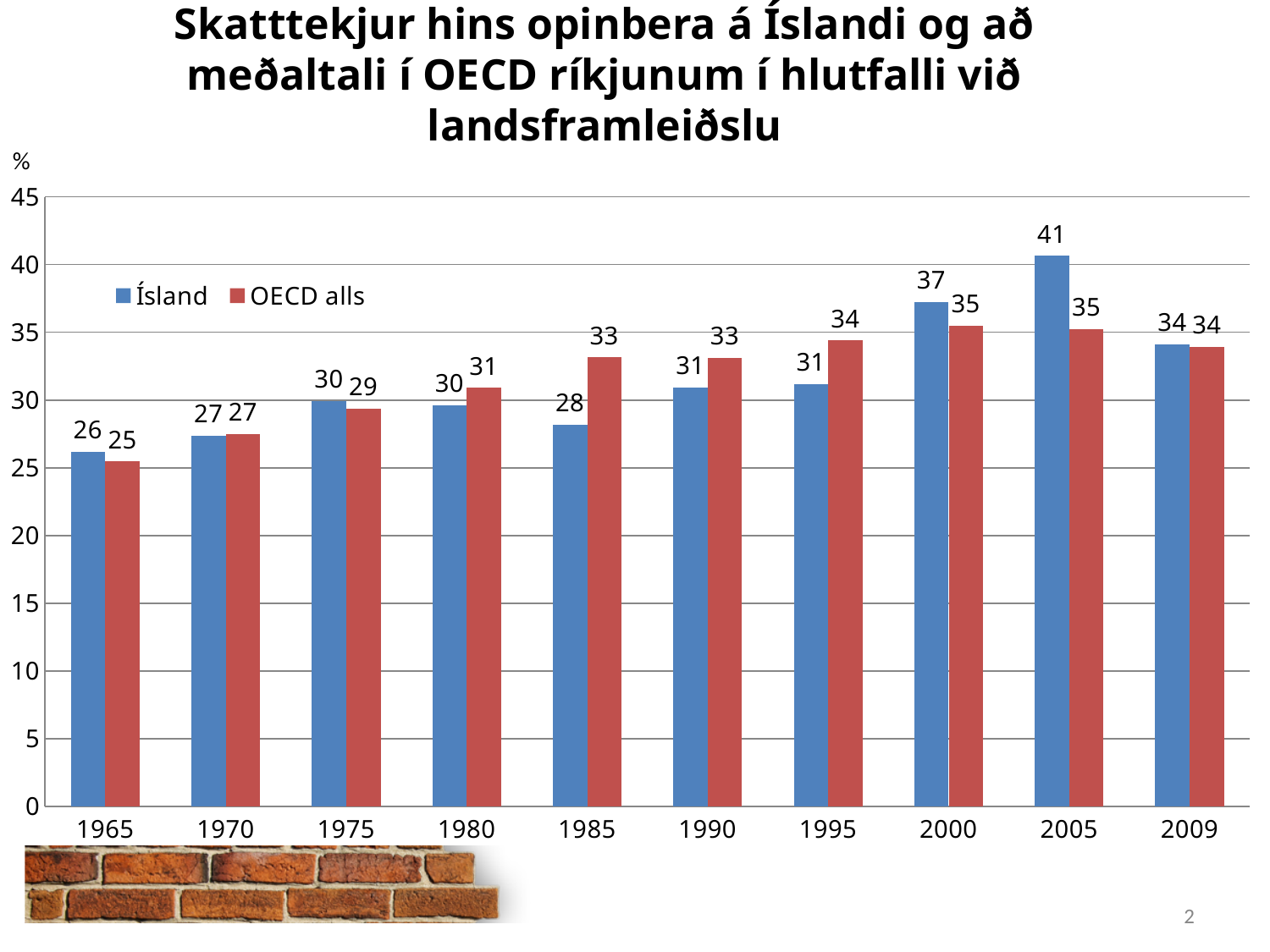
What is the value for OECD alls in 1995? 34 In which year is the OECD alls value lowest? 1965 In which year is the Ísland value highest? 2005 Which is larger in 1985, the Ísland value or the OECD alls value? OECD alls How many series does the legend list? 2 Is the value for Ísland in 2000 greater or less than 35? greater What is the value for Ísland in 2005? 41 How many years are shown on the x axis? 10 What is the difference between the Ísland and OECD alls values in 2005? 6 What kind of chart is shown on the slide? bar chart Which colour represents OECD alls in the chart? red What is the value for Ísland in 1965? 26